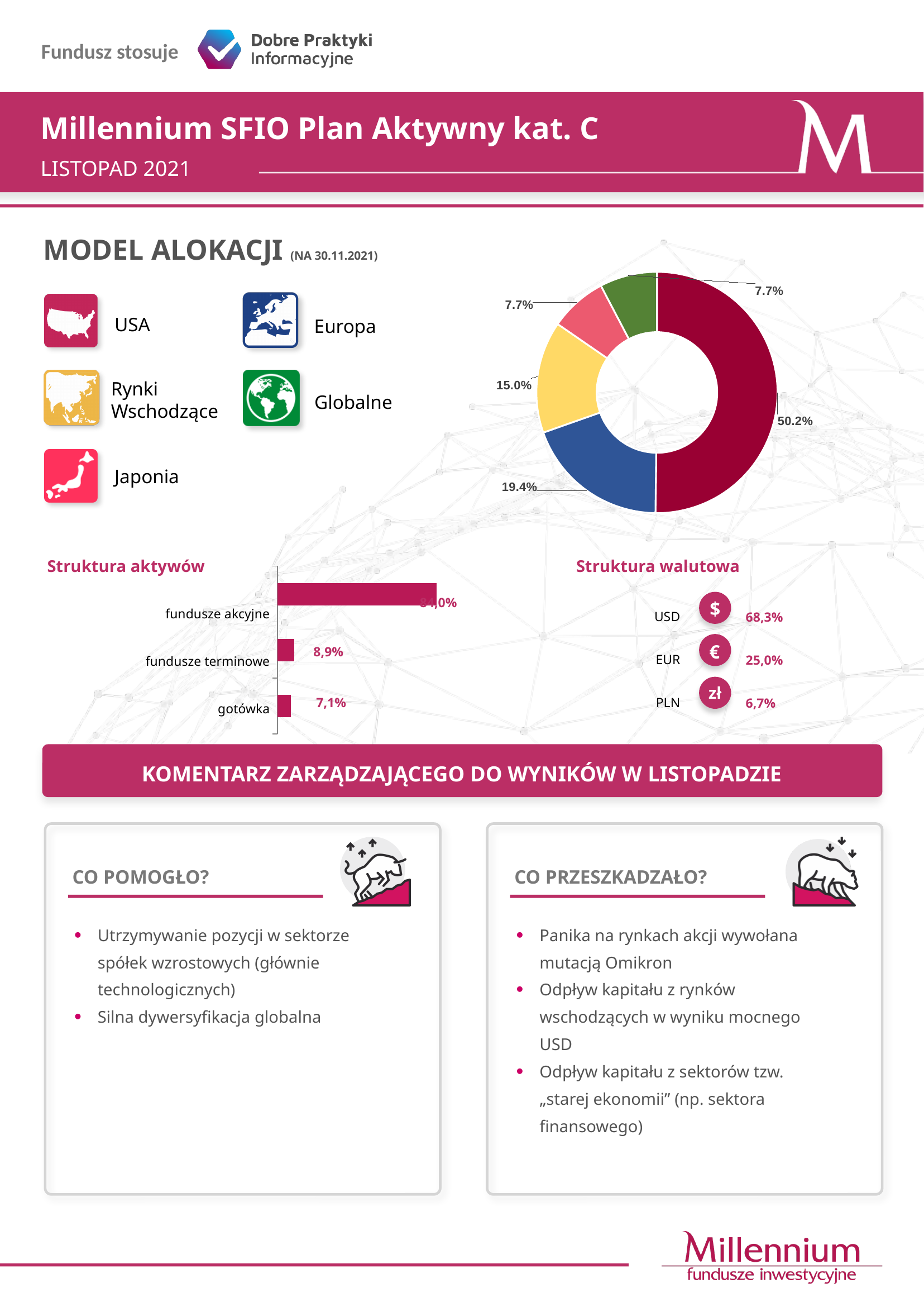
In the Struktura aktywów chart, which category has the lowest value? gotówka In the Struktura aktywów chart, what is the difference between fundusze terminowe and gotówka? 1,8% In the Model alokacji donut chart, what share is shown for Rynki Wschodzące? 15.0% In the Struktura aktywów chart, what is the value for gotówka? 7,1% In the Model alokacji donut chart, which region has the largest share? USA What kind of chart is the Struktura aktywów chart? Bar chart How many segments does the Model alokacji donut chart have? 5 In the Model alokacji donut chart, what is the difference between the USA share and the Europa share? 30.8% In the Struktura aktywów chart, what is the value for fundusze akcyjne? 84,0% In the Model alokacji donut chart, what share is shown for USA? 50.2% What kind of chart is used for Model alokacji? Donut (pie) chart In the Model alokacji donut chart, what share is shown for Europa? 19.4%